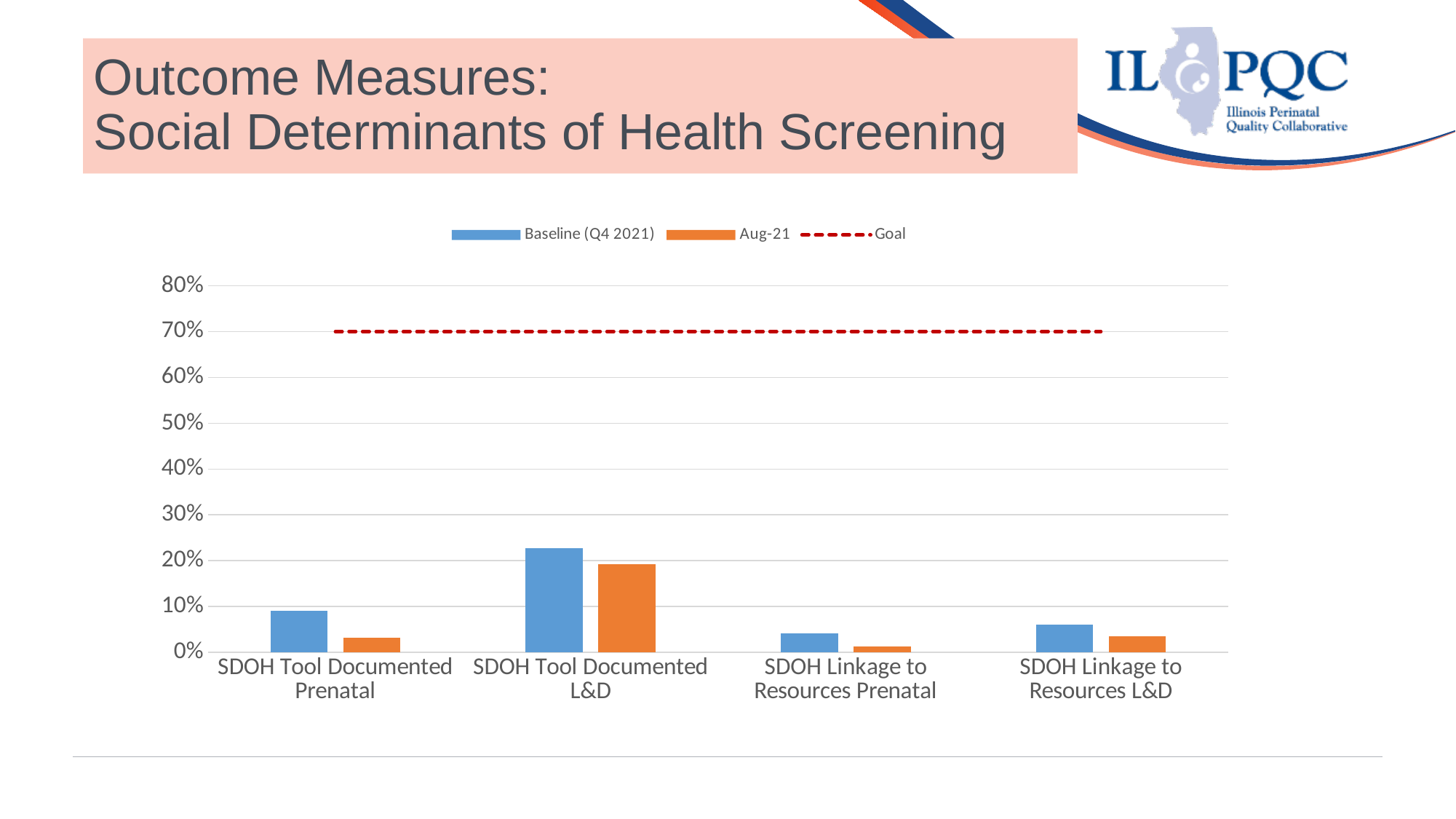
Which category has the highest Baseline (Q4 2021) value? SDOH Tool Documented L&D Is the Baseline (Q4 2021) value for SDOH Tool Documented L&D greater or less than 20%? greater Which colour represents the Aug-21 series in the chart? orange For SDOH Tool Documented L&D, which is larger: the Baseline (Q4 2021) value or the Aug-21 value? Baseline (Q4 2021) Which category has the lowest Aug-21 value? SDOH Linkage to Resources Prenatal How many series does the chart's legend list? 3 At what value is the Goal line drawn on the chart? 70% How many categories are shown along the x axis of the chart? 4 What kind of chart is shown on the slide? bar chart with a dashed goal line (combination bar and line chart) How is the Goal series drawn on the chart? a red dashed line